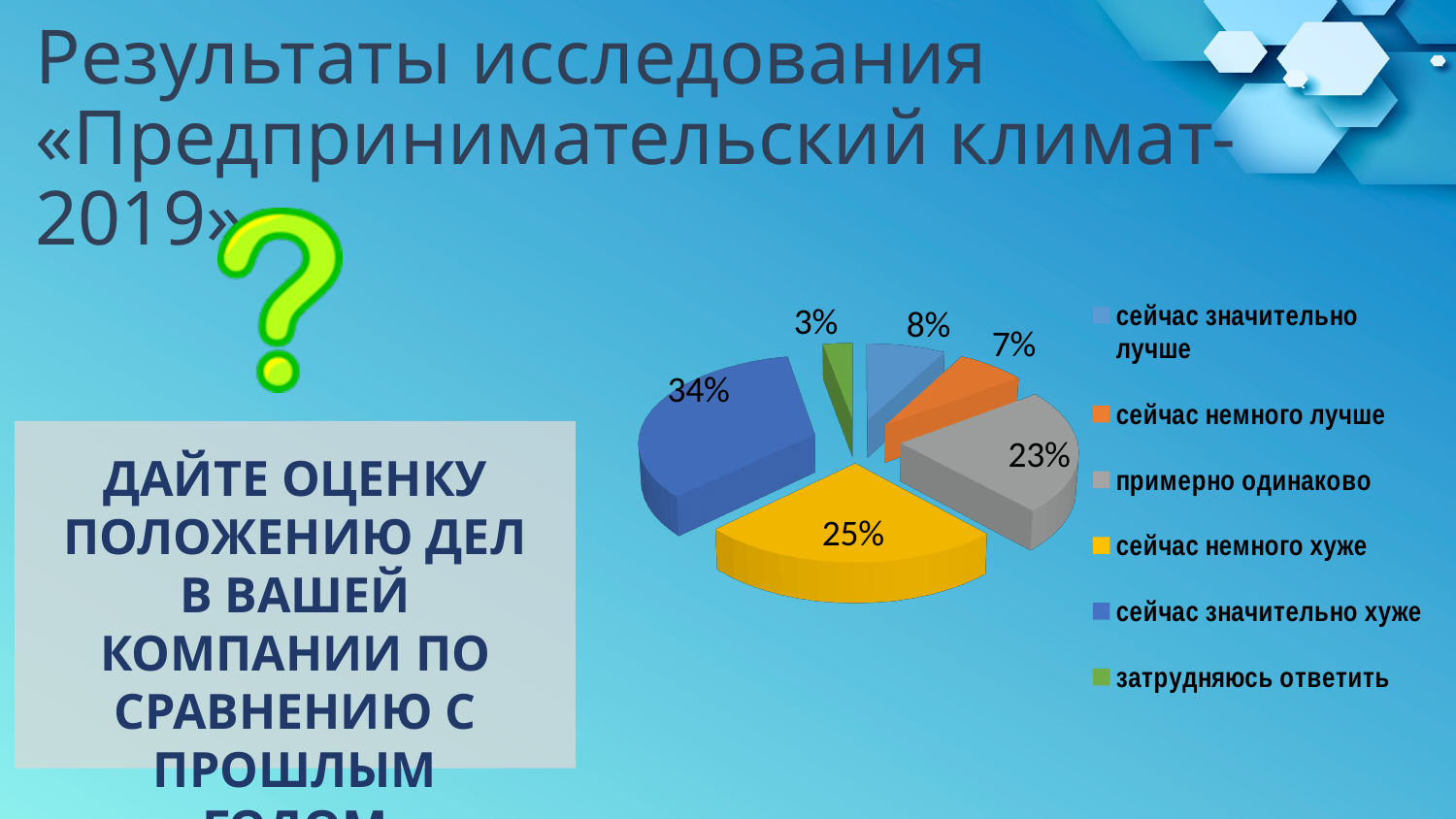
Which answer option has the smallest share of the pie? затрудняюсь ответить Which is larger: the share for "сейчас значительно лучше" or for "сейчас немного лучше"? сейчас значительно лучше What is the difference between the shares for "сейчас значительно хуже" and "сейчас немного хуже"? 9% What share of respondents answered "сейчас значительно хуже"? 34% What share of respondents answered "примерно одинаково"? 23% What share of respondents answered "сейчас значительно лучше"? 8% Which answer option has the largest share of the pie? сейчас значительно хуже What kind of chart is shown on the slide? pie chart How many slices does the pie chart have? 6 What colour is the slice for "сейчас немного хуже"? yellow What share of respondents answered "затрудняюсь ответить"? 3% What share of respondents answered "сейчас немного хуже"? 25%